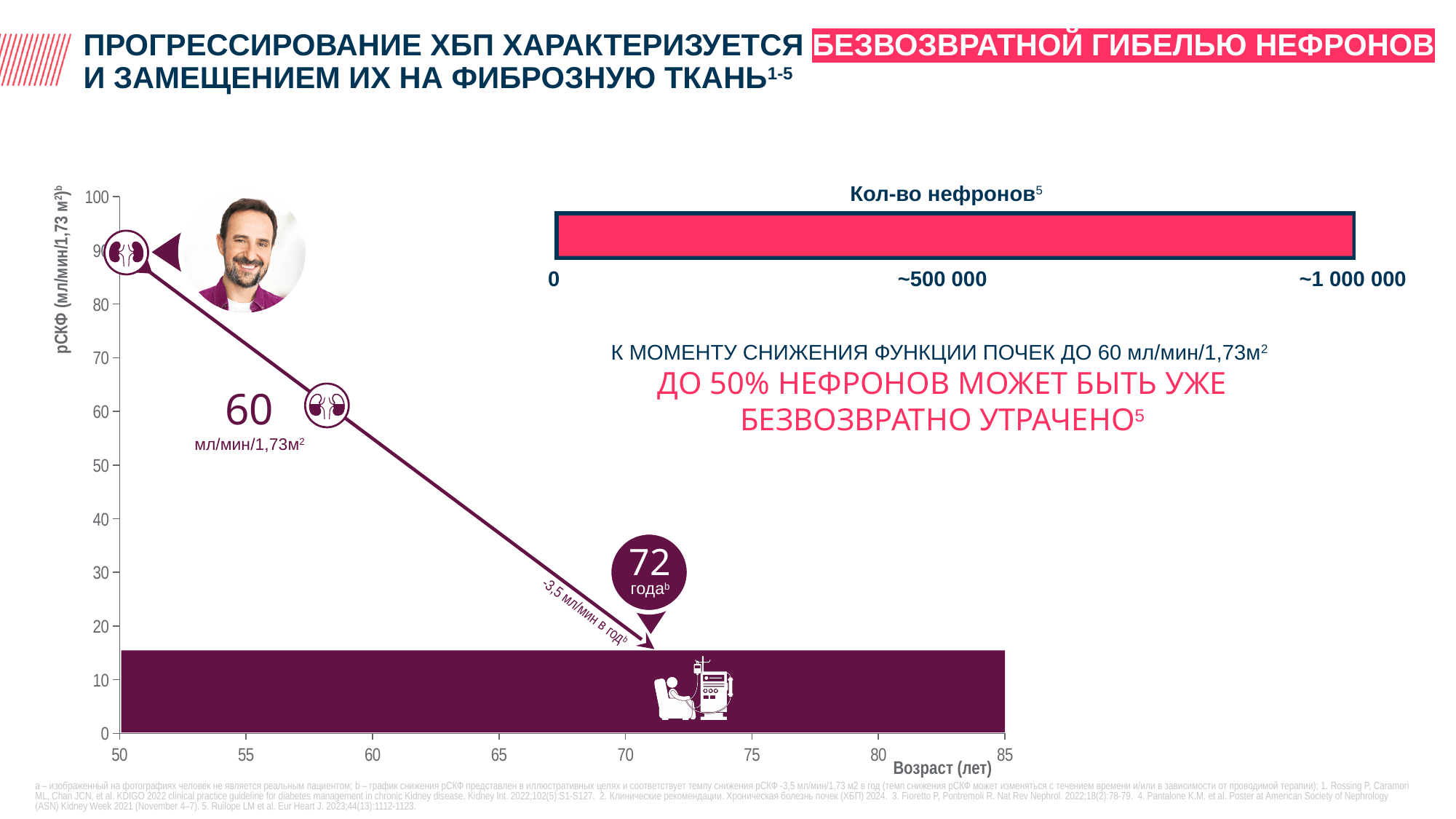
In the 'Кол-во нефронов' bar, what value is marked at the middle of the scale? ~500 000 What рСКФ value is marked by the large label next to the second kidney icon? 60 мл/мин/1,73м² What is the label of the y axis of the line chart? рСКФ (мл/мин/1,73 м²) In the 'Кол-во нефронов' bar, what is the value at the right end of the scale? ~1 000 000 Is the рСКФ value at age 65 greater or less than 50? less Is the рСКФ value at age 55 greater or less than 60? greater What is the highest value shown on the y axis of the line chart? 100 What is the label of the x axis of the line chart? Возраст (лет) Does the рСКФ line rise or fall as age increases along the x axis? falls What annual rate of рСКФ decline is written along the line? -3,5 мл/мин в год At what age does the line reach the dialysis zone, according to the callout? 72 года What kind of chart is shown on the left of the slide? line chart